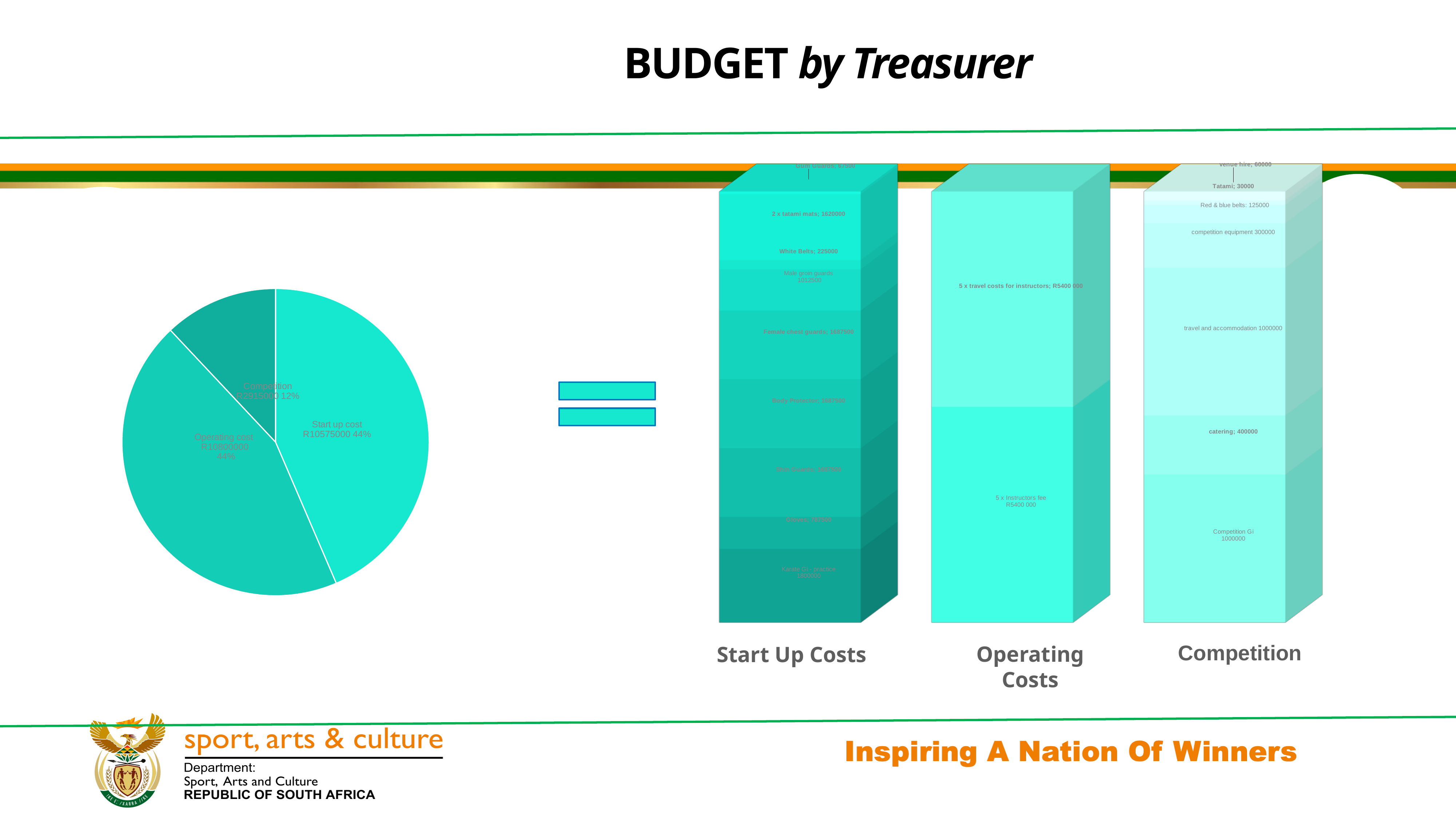
In the pie chart, what value is shown for Operating cost? R10800000 In the stacked bar chart on the right, what value is shown for catering in the Competition bar? 400000 In the pie chart, which category has the smallest slice? Competition How many bars are in the stacked bar chart on the right of the slide? 3 In the pie chart, what value is shown for Start up cost? R10575000 In the stacked bar chart on the right, what value is shown for 5 x travel costs for instructors in the Operating Costs bar? R5400 000 In the stacked bar chart on the right, what value is shown for 2 x tatami mats in the Start Up Costs bar? 1620000 In the pie chart, what value is shown for Competition? R2915000 What kind of chart is shown on the left of the slide? Pie chart How many slices does the pie chart have? 3 In the pie chart, what share of the total does Competition represent? 12% In the pie chart, which is larger, Operating cost or Start up cost? Operating cost